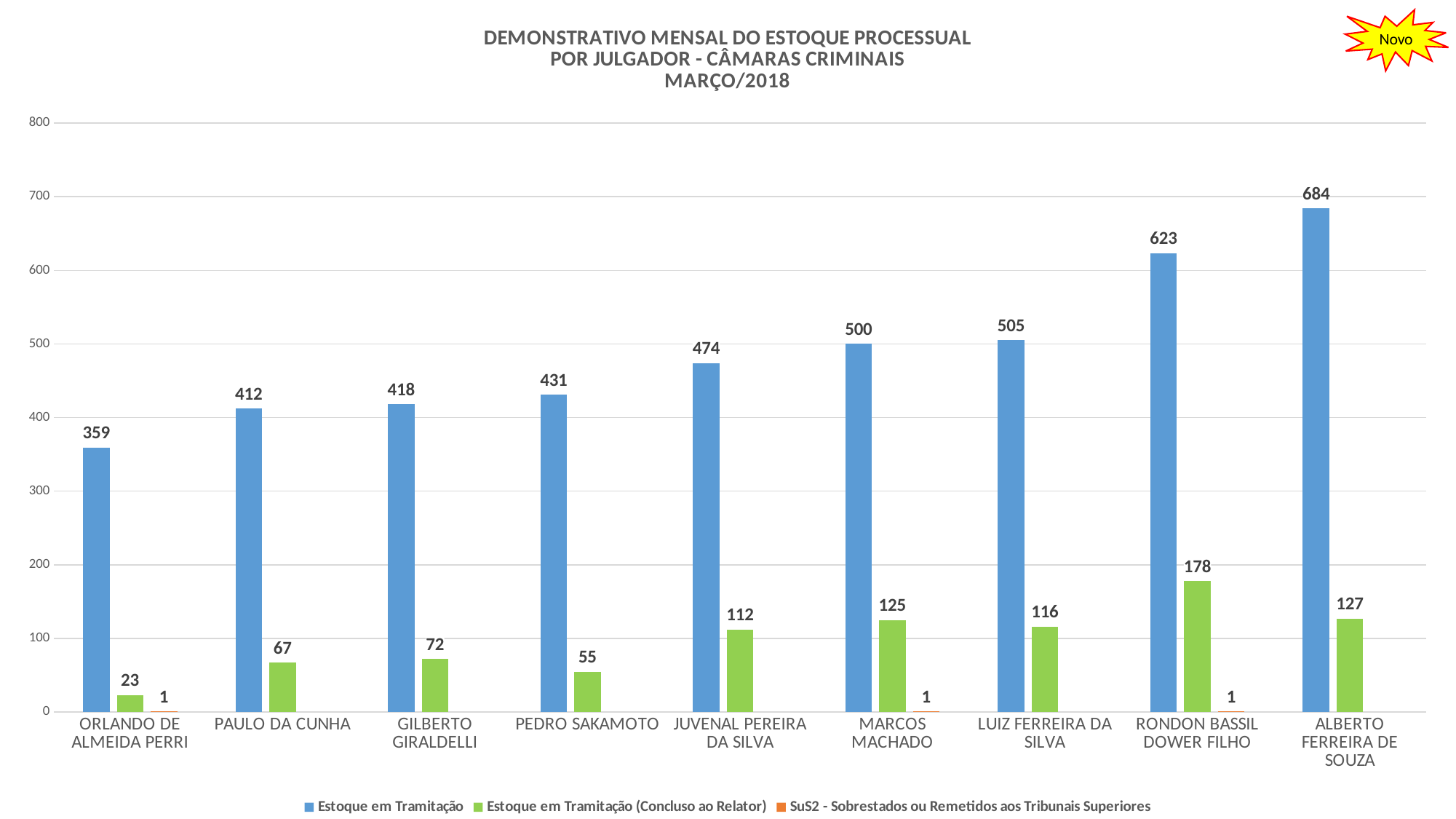
What is the difference between the Estoque em Tramitação values for ALBERTO FERREIRA DE SOUZA and RONDON BASSIL DOWER FILHO? 61 What is the value of Estoque em Tramitação for ALBERTO FERREIRA DE SOUZA? 684 Is the Estoque em Tramitação value for JUVENAL PEREIRA DA SILVA greater or less than 500? less Which month and year does the chart title refer to? MARÇO/2018 How many series does the legend list? 3 What kind of chart is shown on the slide? bar chart Which is larger: the Estoque em Tramitação (Concluso ao Relator) value for MARCOS MACHADO or for LUIZ FERREIRA DA SILVA? MARCOS MACHADO What is the value of Estoque em Tramitação (Concluso ao Relator) for RONDON BASSIL DOWER FILHO? 178 Which judge has the lowest value for Estoque em Tramitação (Concluso ao Relator)? ORLANDO DE ALMEIDA PERRI What is the value of Estoque em Tramitação for PEDRO SAKAMOTO? 431 Which judge has the highest value for Estoque em Tramitação? ALBERTO FERREIRA DE SOUZA How many judges are shown on the x axis? 9